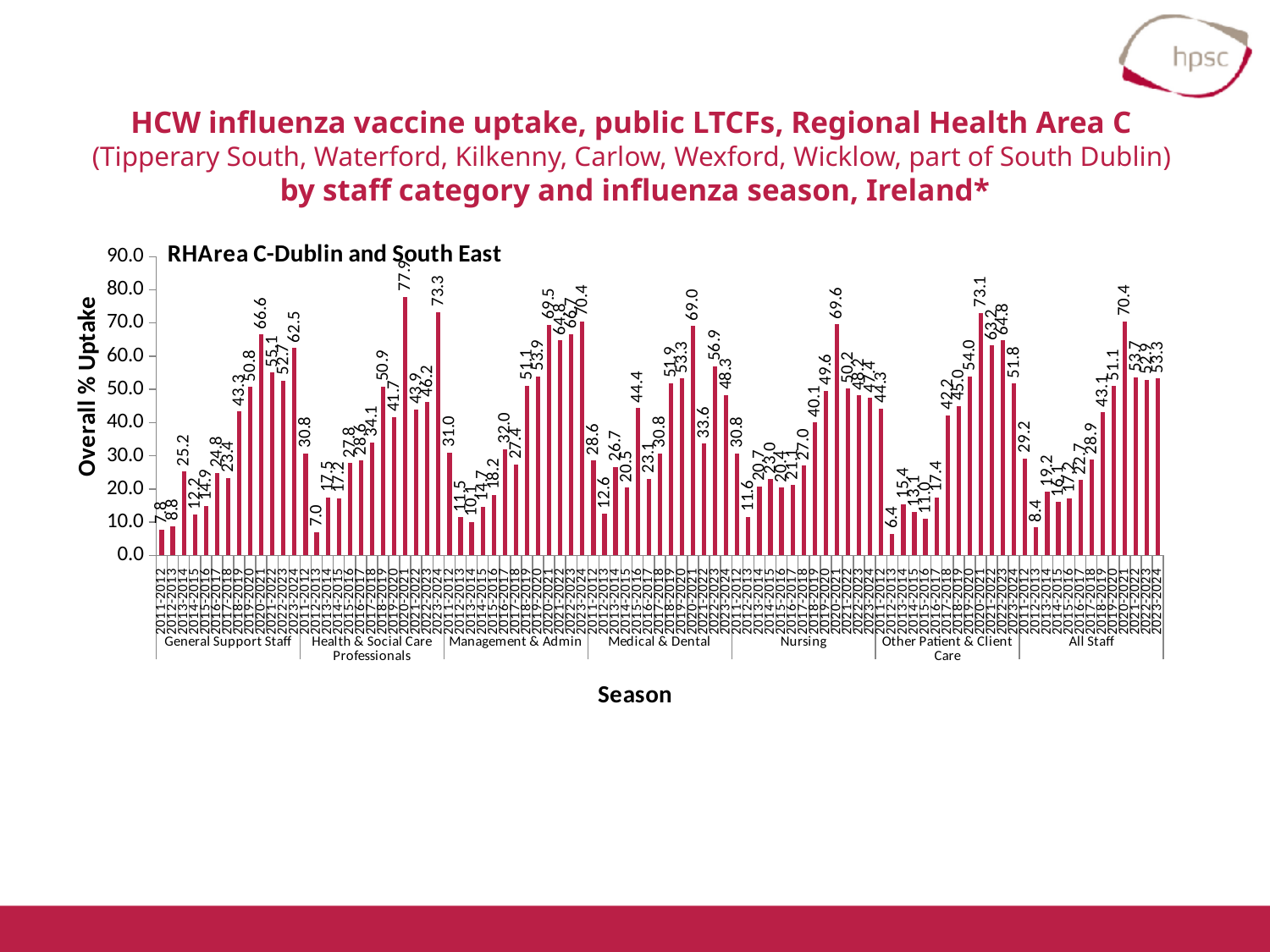
What is the label on the y axis of the chart? Overall % Uptake What kind of chart is shown on the slide? Bar chart What is the overall % uptake for Medical & Dental in the 2020-2021 season? 69.0 Which staff category and season has the highest overall % uptake on the chart? Health & Social Care Professionals, 2020-2021 (77.9) What is the overall % uptake for General Support Staff in the 2020-2021 season? 66.6 What is the lowest overall % uptake shown for Other Patient & Client Care, and in which season? 6.4, 2012-2013 How many staff categories are shown along the x axis? 7 What is the overall % uptake for General Support Staff in the 2011-2012 season? 7.8 What is the overall % uptake for Health & Social Care Professionals in the 2012-2013 season? 7.0 What is the overall % uptake for Management & Admin in the 2023-2024 season? 70.4 What is the difference between the 2020-2021 and 2012-2013 overall % uptake for Health & Social Care Professionals? 70.9 In the 2023-2024 season, which has the higher overall % uptake: General Support Staff or Health & Social Care Professionals? Health & Social Care Professionals